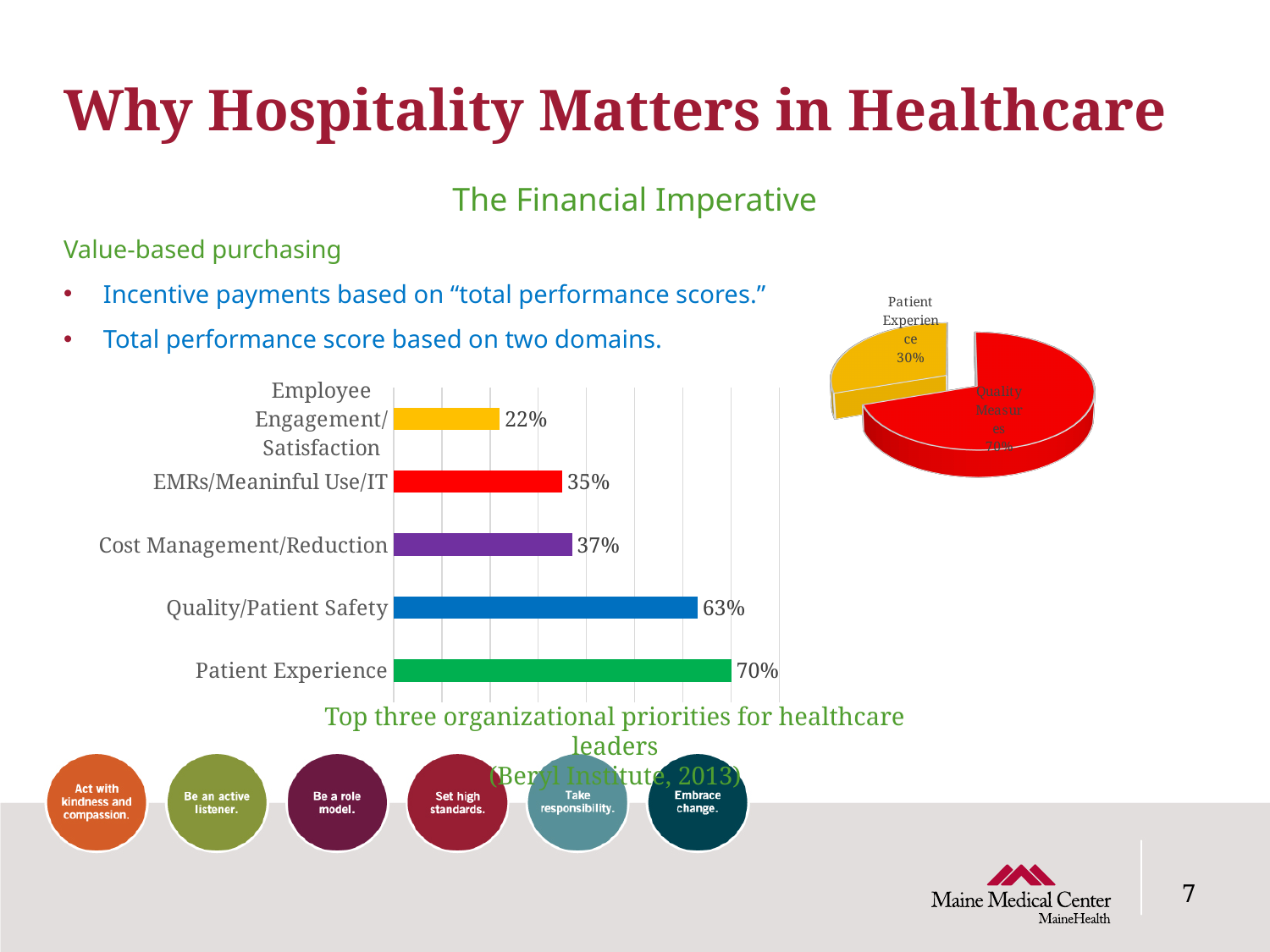
How many slices does the pie chart at the top right of the slide have? 2 In the bar chart titled 'Top three organizational priorities for healthcare leaders', what is the value for Patient Experience? 70% In the bar chart titled 'Top three organizational priorities for healthcare leaders', which category has the lowest value? Employee Engagement/Satisfaction In the pie chart at the top right of the slide, what share does Patient Experience have? 30% In the bar chart titled 'Top three organizational priorities for healthcare leaders', what is the value for Cost Management/Reduction? 37% In the bar chart titled 'Top three organizational priorities for healthcare leaders', which is larger: EMRs/Meaninful Use/IT or Cost Management/Reduction? Cost Management/Reduction How many categories are shown in the bar chart titled 'Top three organizational priorities for healthcare leaders'? 5 What kind of chart is shown at the top right of the slide? Pie chart In the bar chart titled 'Top three organizational priorities for healthcare leaders', what is the difference between Patient Experience and Quality/Patient Safety? 7% What kind of chart is the chart titled 'Top three organizational priorities for healthcare leaders'? Bar chart In the bar chart titled 'Top three organizational priorities for healthcare leaders', which category has the highest value? Patient Experience In the bar chart titled 'Top three organizational priorities for healthcare leaders', what is the value for Employee Engagement/Satisfaction? 22%